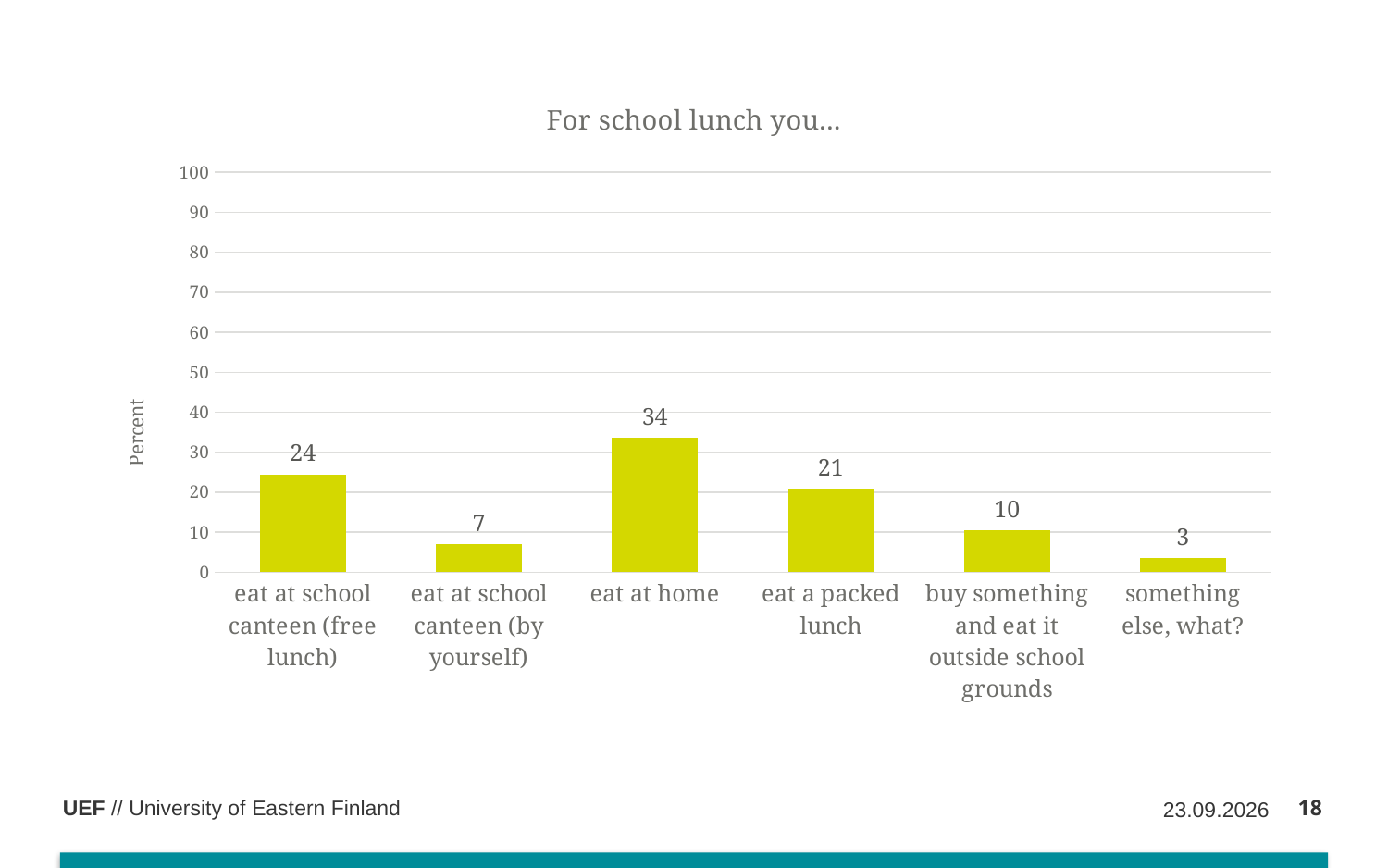
Which is larger, the value for "eat at school canteen (free lunch)" or "eat a packed lunch"? eat at school canteen (free lunch) What is the title of the chart? For school lunch you... Which category has the lowest value? something else, what? What is the value for "eat at home"? 34 What kind of chart is shown on the slide? bar chart What is the value for "buy something and eat it outside school grounds"? 10 What is the difference between the values for "eat at home" and "eat a packed lunch"? 13 Which category has the highest value? eat at home How many categories are shown on the x axis? 6 What is the label of the y axis? Percent Is the value for "eat at school canteen (by yourself)" greater or less than 10? less What is the value for "eat at school canteen (free lunch)"? 24